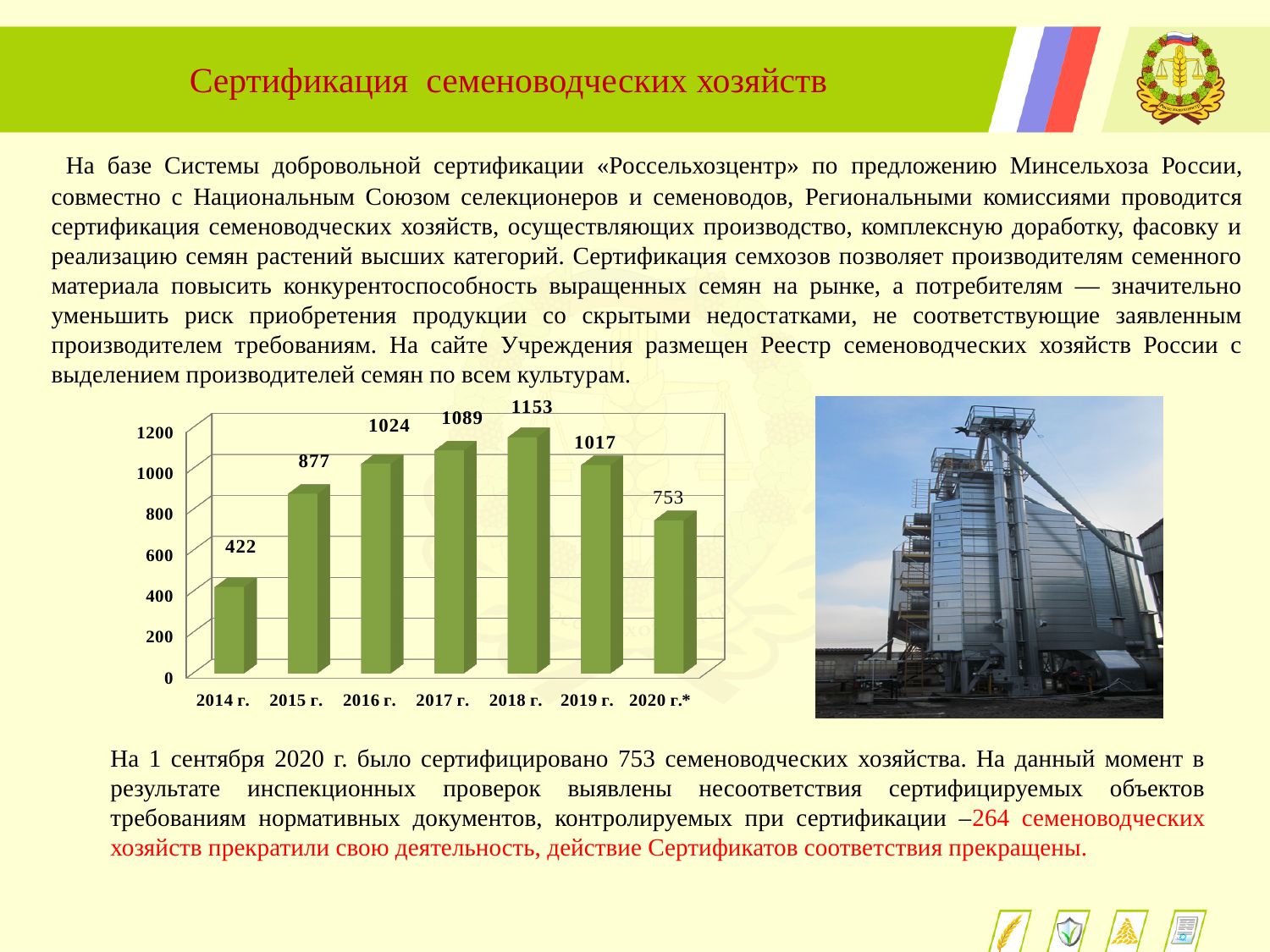
Which year has the lowest value? 2014 г. How many years are shown on the x axis? 7 What is the value for 2020 г.*? 753 What is the value for 2014 г.? 422 Which year has the highest value? 2018 г. Do the values rise or fall from 2014 г. to 2018 г.? rise What kind of chart is shown on the slide? bar chart What is the value for 2018 г.? 1153 Which is larger, the value for 2016 г. or the value for 2019 г.? 2016 г. Is the value for 2017 г. greater or less than 1000? greater What is the difference between the values for 2018 г. and 2019 г.? 136 What is the difference between the values for 2015 г. and 2014 г.? 455